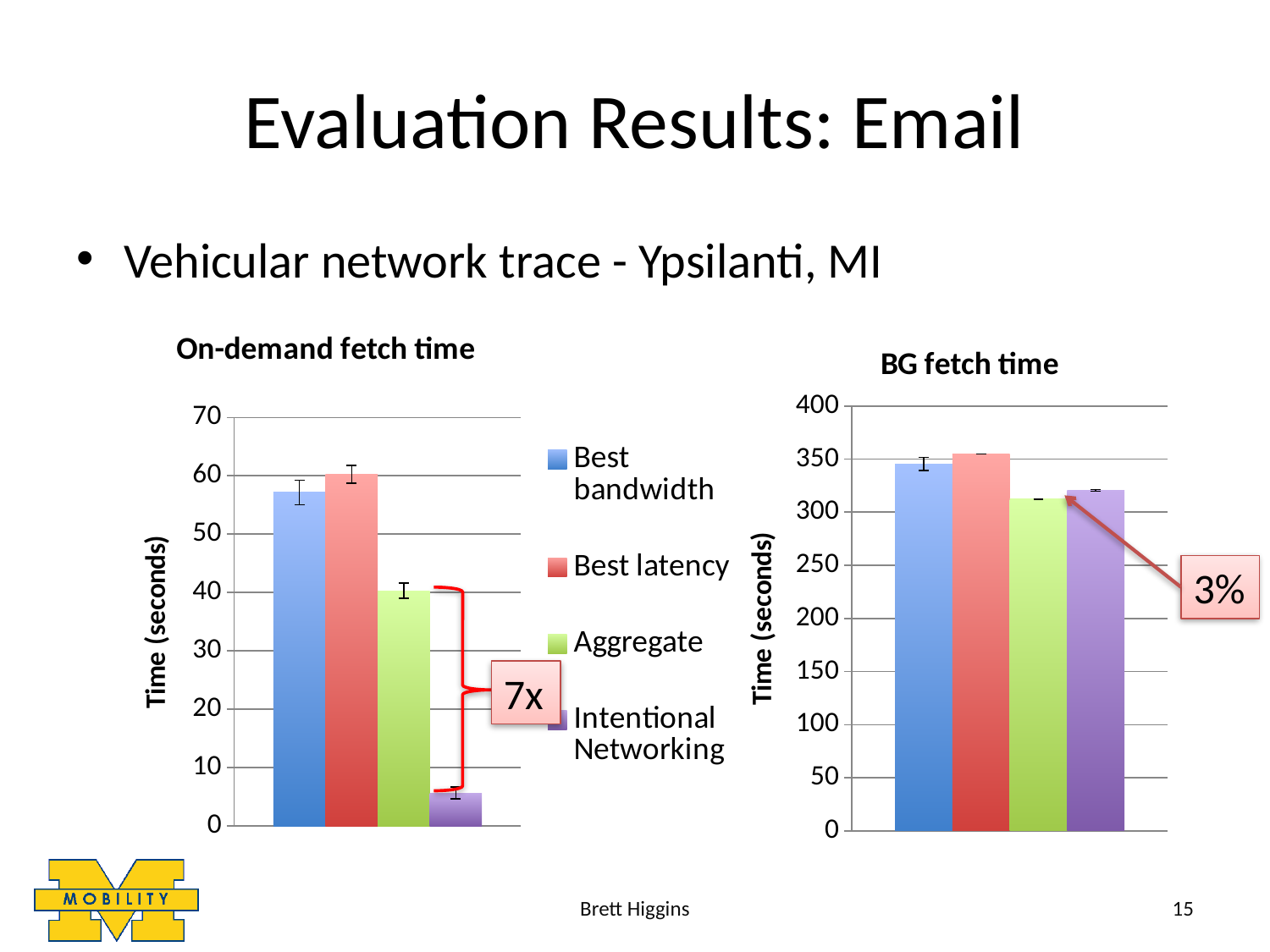
In the "On-demand fetch time" chart, is the value for Best bandwidth greater or less than 50? greater In the "On-demand fetch time" chart, which is larger, Aggregate or Intentional Networking? Aggregate What kind of chart is the "On-demand fetch time" chart? bar chart In the "BG fetch time" chart, which is larger, Best bandwidth or Aggregate? Best bandwidth What is the y-axis title of the "BG fetch time" chart? Time (seconds) In the "On-demand fetch time" chart, which series has the lowest value? Intentional Networking In the "On-demand fetch time" chart, is the value for Intentional Networking greater or less than 10? less In the "On-demand fetch time" chart, do the bar values generally rise or fall from left to right? fall How many series does the legend list for the "On-demand fetch time" chart? 4 In the "BG fetch time" chart, is the value for Aggregate greater or less than 300? greater How many bars are plotted in the "BG fetch time" chart? 4